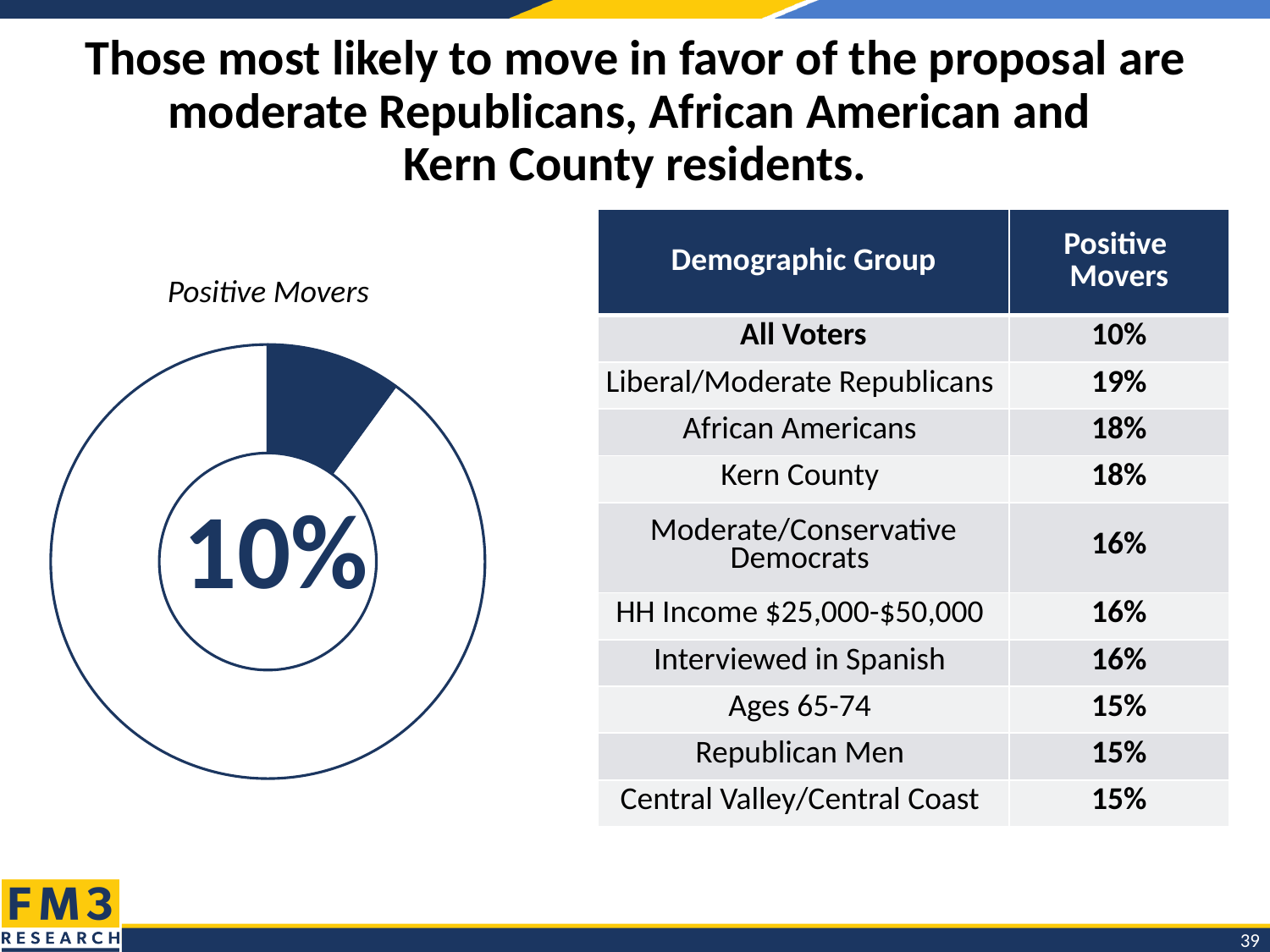
According to the table, which demographic group has the highest Positive Movers value? Liberal/Moderate Republicans According to the table, what is the Positive Movers value for All Voters? 10% According to the table, which is larger: the Positive Movers value for African Americans or for Republican Men? African Americans What is the title of the chart on the left of the slide? Positive Movers What colour is the filled segment of the Positive Movers donut chart? Dark blue According to the table, what is the difference between the Positive Movers value for Liberal/Moderate Republicans and All Voters? 9 percentage points In the Positive Movers donut chart, what share of the ring is filled in dark blue? 10% What percentage is shown in the center of the Positive Movers donut chart? 10% What kind of chart is shown on the left of the slide? Donut chart Is the filled portion of the Positive Movers donut chart greater or less than 50%? less How many demographic groups are listed in the table? 10 According to the table, what is the Positive Movers value for Kern County? 18%